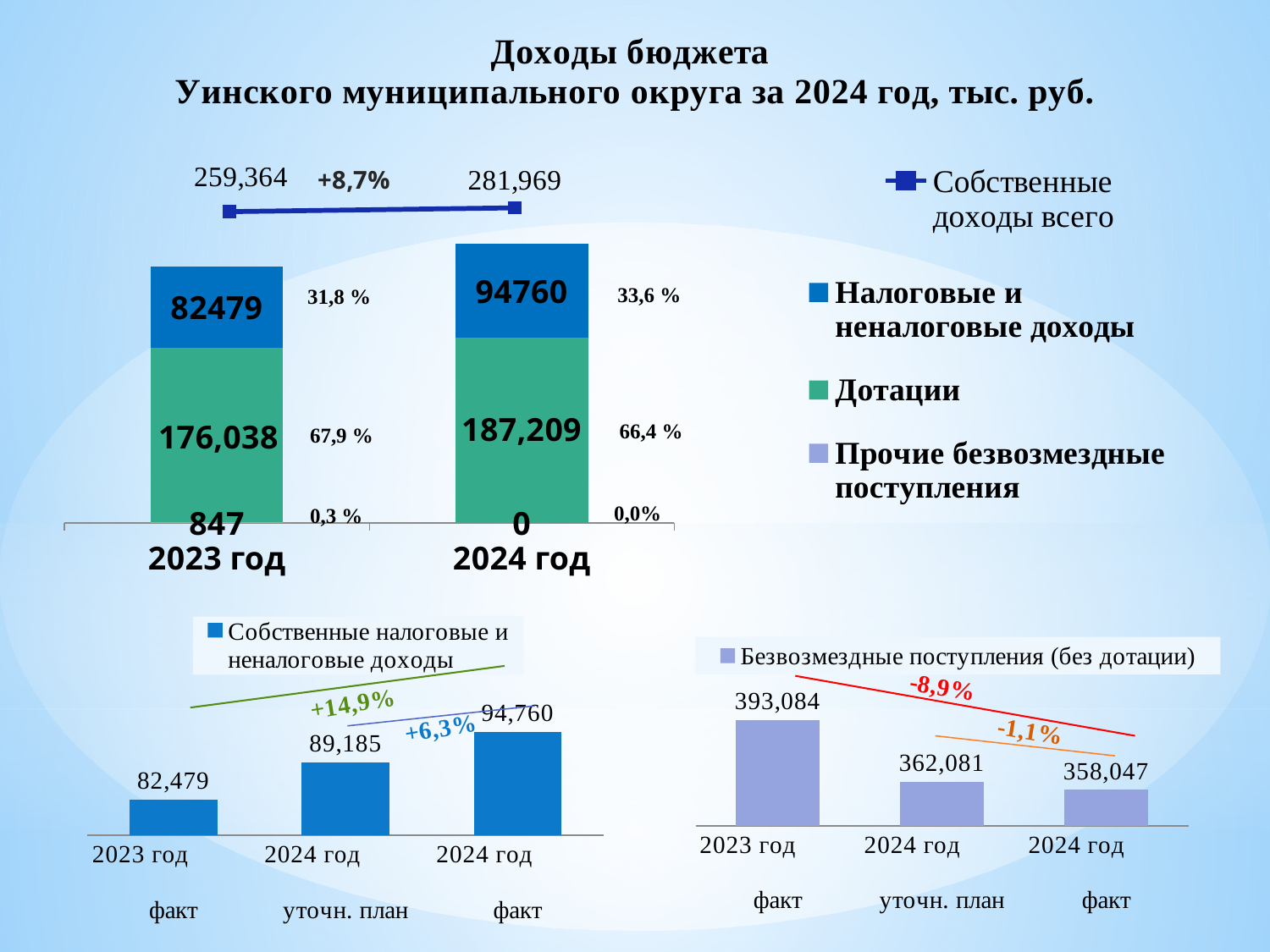
In the top chart, what percentage change is shown on the Собственные доходы всего line between 2023 and 2024? +8,7% In the bottom-right chart (Безвозмездные поступления (без дотации)), which category has the lowest value? 2024 год факт How many series does the legend of the top chart list? 4 In the bottom-left chart (Собственные налоговые и неналоговые доходы), which category has the highest value? 2024 год факт How many bars are in the bottom-left chart (Собственные налоговые и неналоговые доходы)? 3 In the top chart, what is the difference between Налоговые и неналоговые доходы in 2024 год and in 2023 год? 12281 In the top chart, what is the value of Собственные доходы всего for 2024 год? 281,969 In the top stacked bar chart, what is the value of Налоговые и неналоговые доходы for 2023 год? 82479 In the bottom-left chart (Собственные налоговые и неналоговые доходы), what is the value for 2024 год уточн. план? 89,185 In the bottom-left chart (Собственные налоговые и неналоговые доходы), do the values rise or fall from left to right? rise In the bottom-right chart (Безвозмездные поступления (без дотации)), what is the difference between 2023 год факт and 2024 год уточн. план? 31,003 In the top stacked bar chart, what is the value of Дотации for 2024 год? 187,209